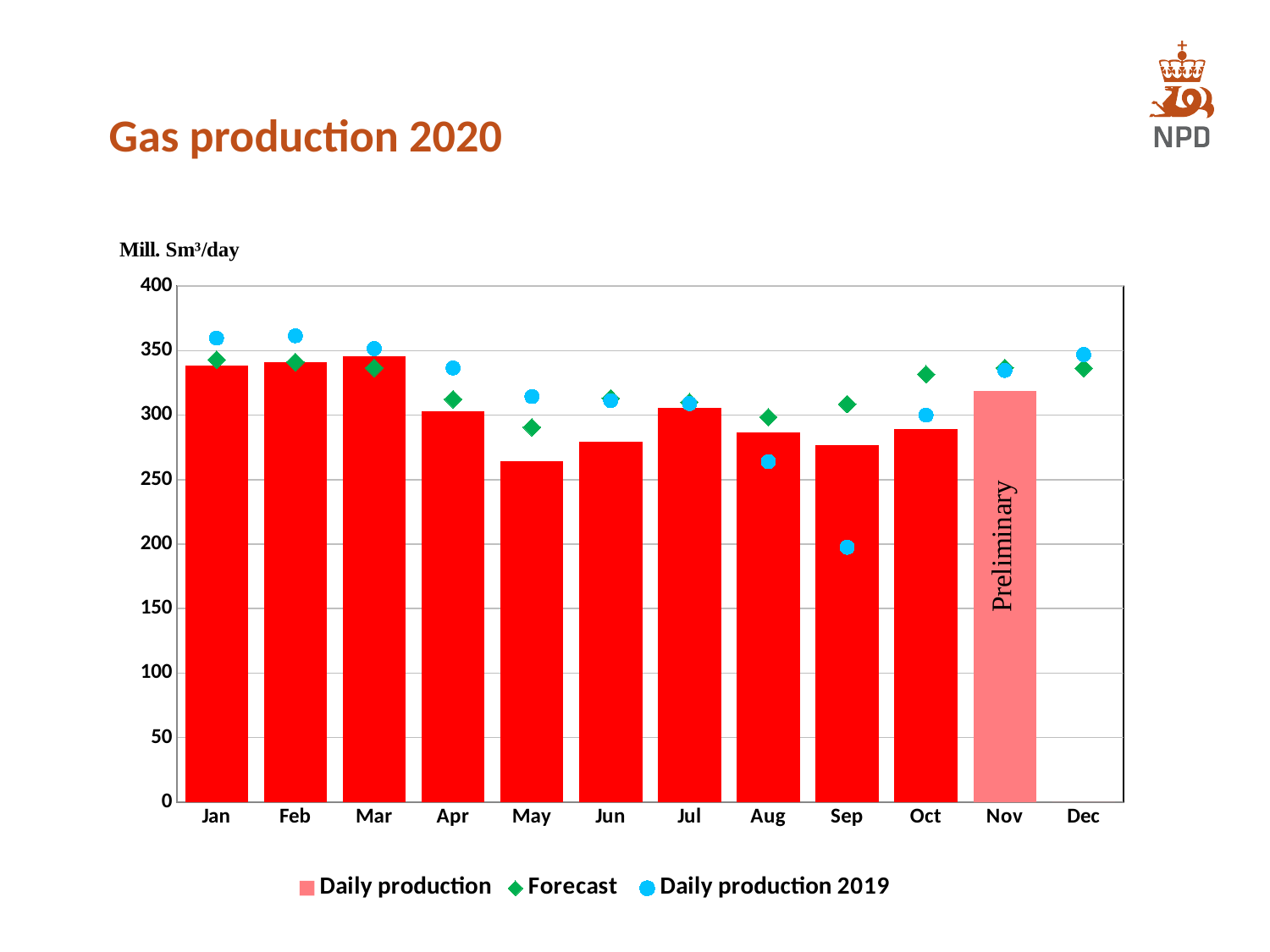
Which is larger, the Daily production bar for Jan or for May? Jan Is the Daily production value for Nov greater or less than 300? greater How many months are shown on the x axis? 12 Is the Daily production value for May greater or less than 300? less What kind of chart is shown on the slide? bar chart Which month has the lowest Daily production 2019 value? Sep In Sep, which is larger, the Daily production bar or the Daily production 2019 value? Daily production Is the Daily production 2019 value for Sep greater or less than 250? less Which month has the lowest Daily production bar? May How many series does the legend list? 3 What word is written on the Nov bar? Preliminary Do the Daily production bars rise or fall from Mar to May? fall